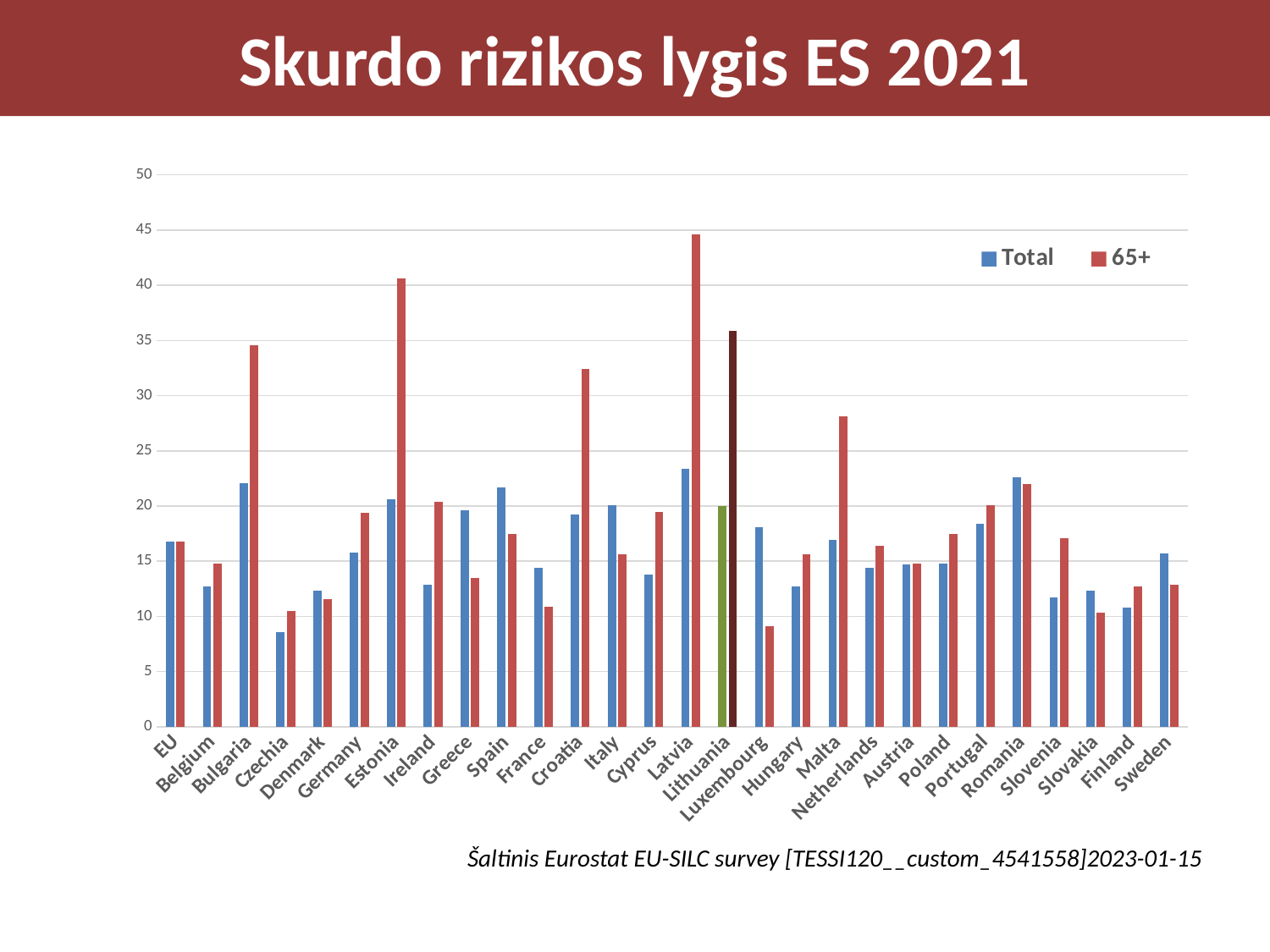
For Lithuania, which is larger: the Total value or the 65+ value? 65+ Is the 65+ value for Luxembourg greater or less than 10? less Is the 65+ value for Latvia greater or less than 40? greater Which is larger: the 65+ value for Estonia or the 65+ value for Croatia? Estonia Which category has the highest value for the 65+ series? Latvia How many series does the legend list? 2 What is the title of the chart? Skurdo rizikos lygis ES 2021 Which category has the lowest value for the Total series? Czechia Which category has the lowest value for the 65+ series? Luxembourg Is the 65+ value for Bulgaria greater or less than 30? greater How many countries/categories are shown on the x axis? 28 What kind of chart is shown on the slide? Bar chart